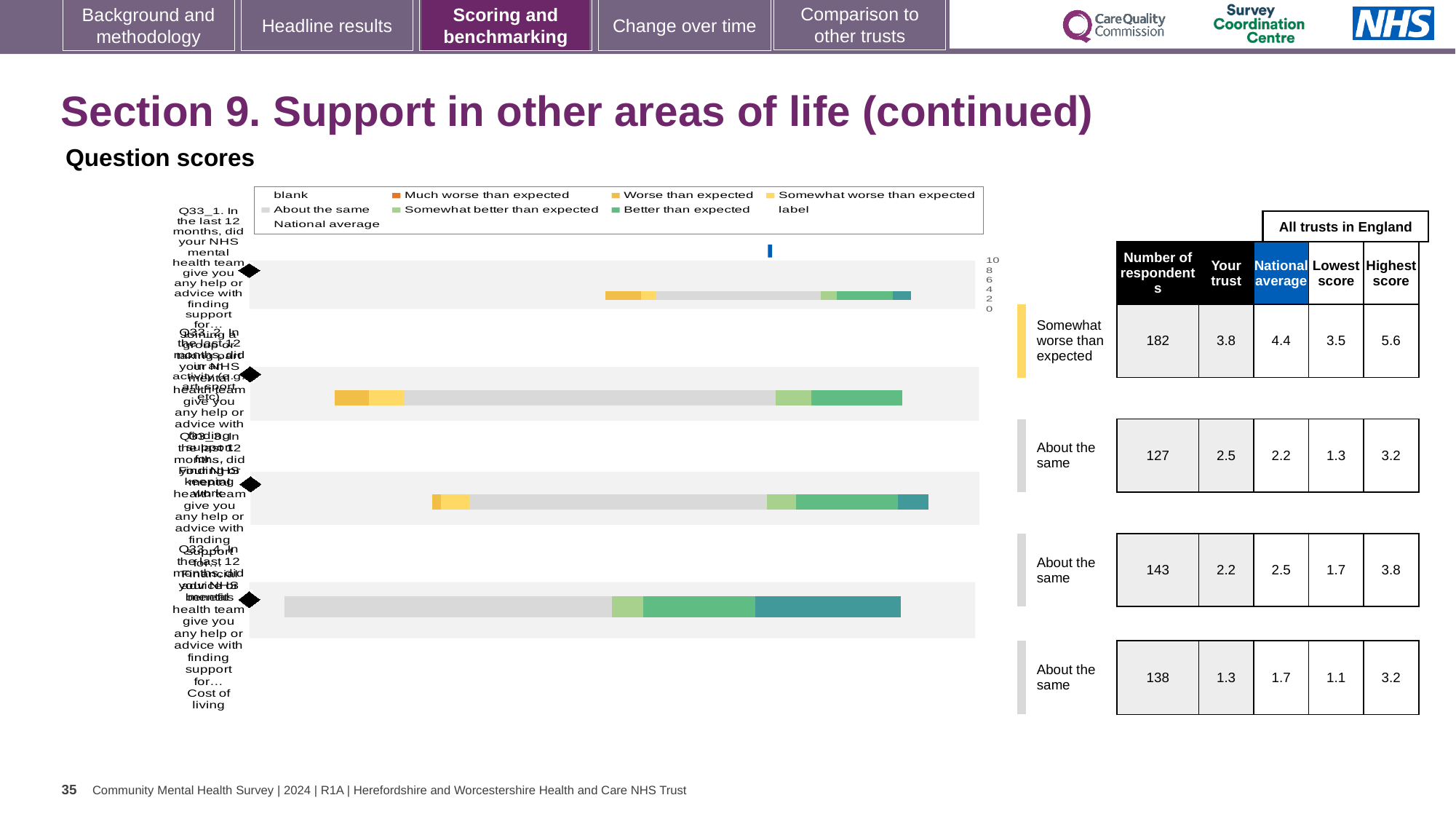
What kind of chart is used to show the question scores on this slide? bar chart Which legend entry is shown in dark orange? Much worse than expected Which legend entry is shown in light grey? About the same How many respondents answered the third question (Q33_3)? 143 What is the 'Your trust' score for the first question (Q33_1)? 3.8 What benchmark label is given for the last bar (Q33_4, Cost of living)? About the same What is the national average score for the last question (Q33_4, Cost of living)? 1.7 Which question has the highest number of respondents? Q33_1 How many question bars are plotted in the chart? 4 What benchmark label is given for the first bar (Q33_1)? Somewhat worse than expected For the first question (Q33_1), what is the difference between the national average and the 'Your trust' score? 0.6 Which question has the lowest number of respondents? Q33_2